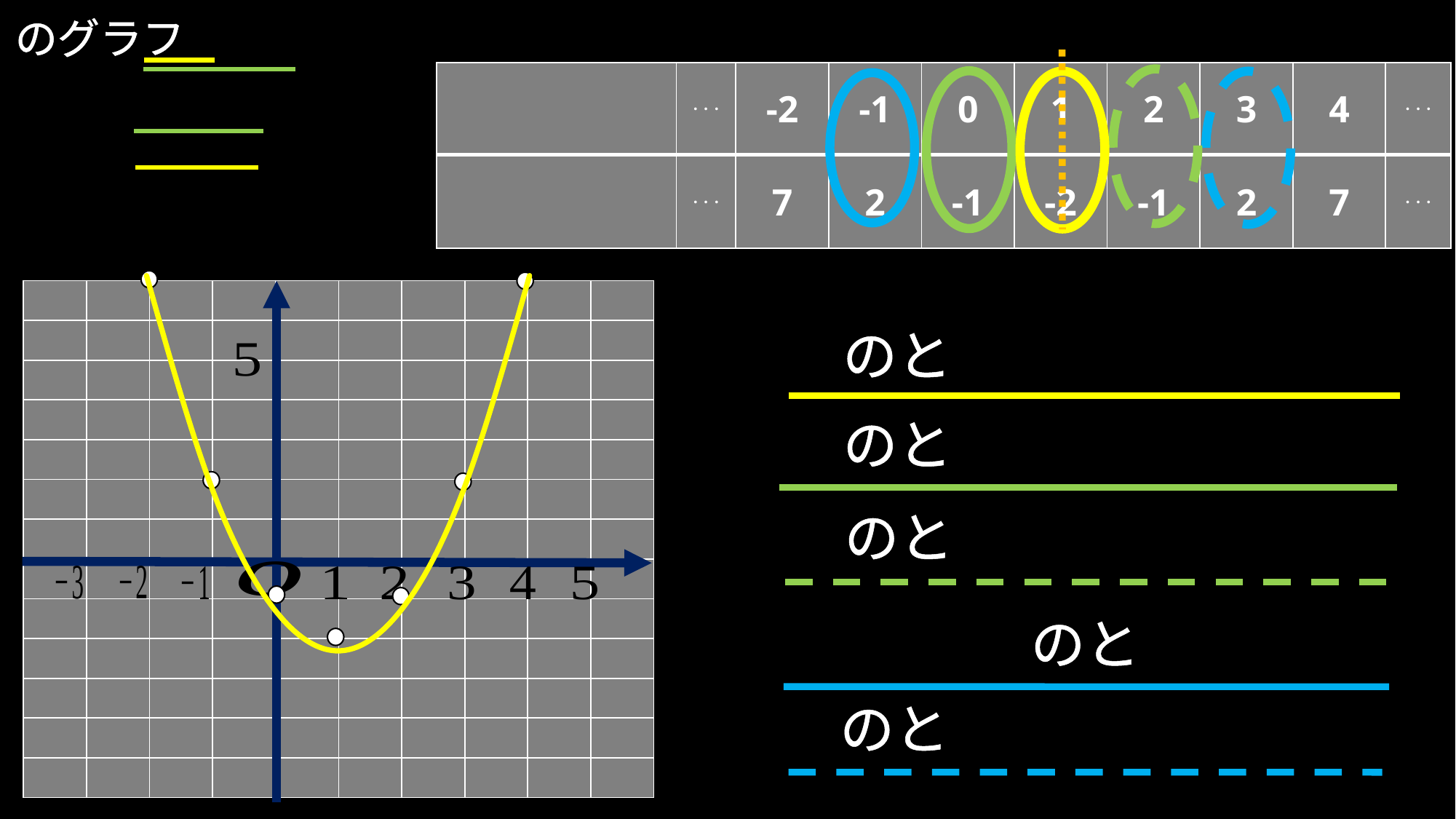
In the table, what value appears in the bottom row directly below 1? -2 In the table, what value appears in the bottom row directly below 0? -1 In the table, which top-row value has the lowest bottom-row value? 1 On the graph, do the y values rise or fall as x increases from 1 to 4? rise What kind of chart is shown on the left of the slide? a line graph (parabola curve) In the table, which is larger: the bottom-row value below -1 or the bottom-row value below 0? the value below -1 On the graph, is the y value of the plotted point at x = 4 greater or less than 5? greater In the table, what value appears in the bottom row directly below 3? 2 How many points are plotted on the graph? 7 In the table, what value appears in the bottom row directly below -2? 7 On the graph, is the y value of the plotted point at x = 1 greater or less than 0? less In the table, what is the difference between the bottom-row values below 4 and below 3? 5